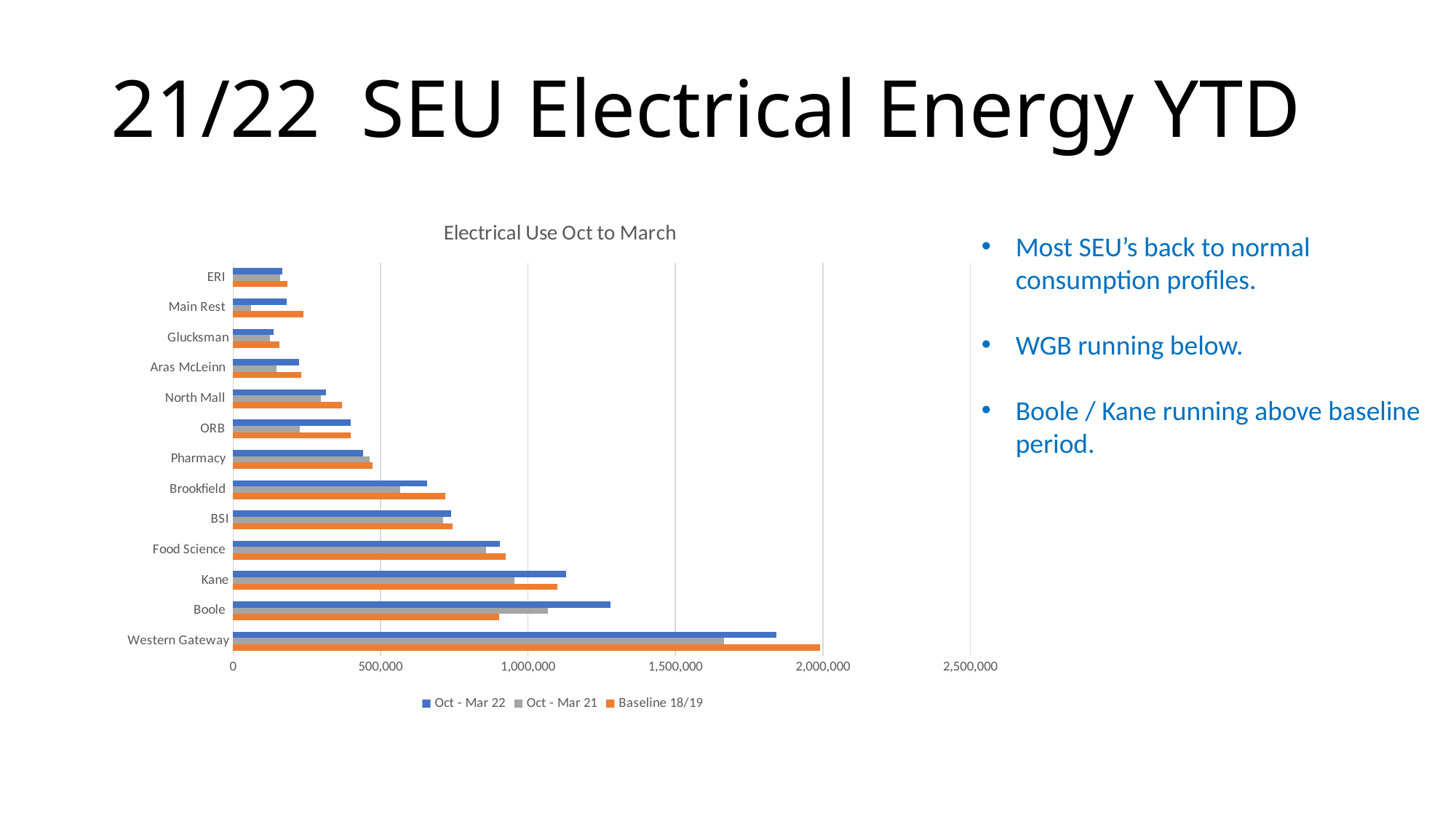
Which category has the highest Oct - Mar 22 value? Western Gateway What is the title of the chart? Electrical Use Oct to March How many categories (buildings) are shown on the chart? 13 Is the Oct - Mar 22 value for Western Gateway greater or less than 1,500,000? greater Is the Oct - Mar 22 value for Boole greater or less than 1,000,000? greater For Boole, which is larger: the Oct - Mar 22 value or the Baseline 18/19 value? Oct - Mar 22 How many series does the chart's legend list? 3 Is the Baseline 18/19 value for Kane greater or less than 1,000,000? greater What kind of chart is shown on the slide? Bar chart Which category has the lowest Oct - Mar 21 value? Main Rest For Western Gateway, which is larger: the Oct - Mar 22 value or the Baseline 18/19 value? Baseline 18/19